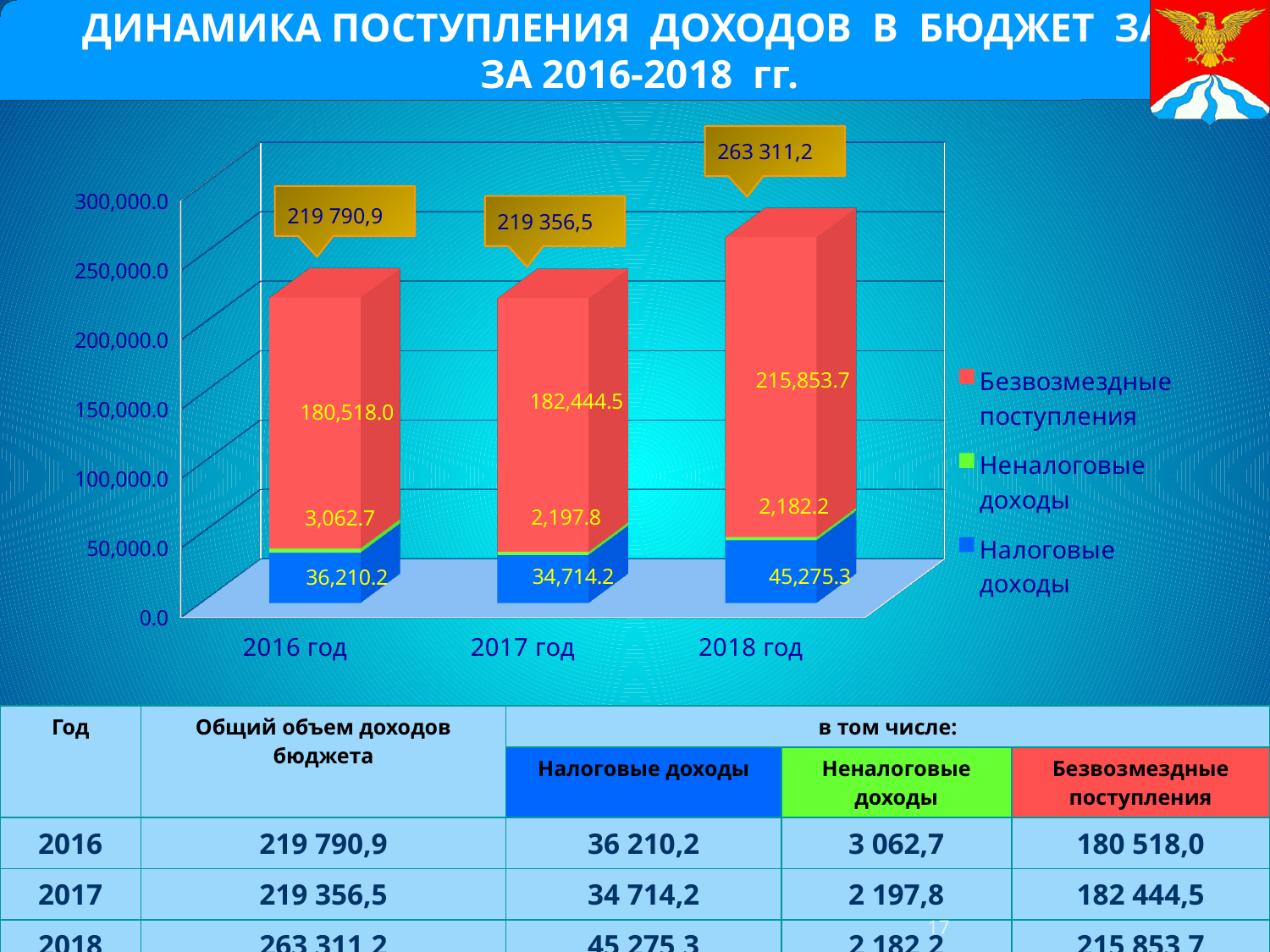
What is the value of Безвозмездные поступления for 2017 год? 182,444.5 Which is larger: Безвозмездные поступления in 2016 год or in 2017 год? 2017 год In which year is Неналоговые доходы the lowest? 2018 год In which year is Налоговые доходы the highest? 2018 год What is the value of Налоговые доходы for 2016 год? 36,210.2 How many series does the legend list? 3 What is the difference in Безвозмездные поступления between 2018 год and 2016 год? 35,335.7 What kind of chart is shown on the slide? Stacked bar chart What is the difference in Налоговые доходы between 2018 год and 2017 год? 10,561.1 What is the value of Неналоговые доходы for 2018 год? 2,182.2 What is the total shown for the 2018 год bar? 263 311,2 What is the total shown for the 2016 год bar? 219 790,9